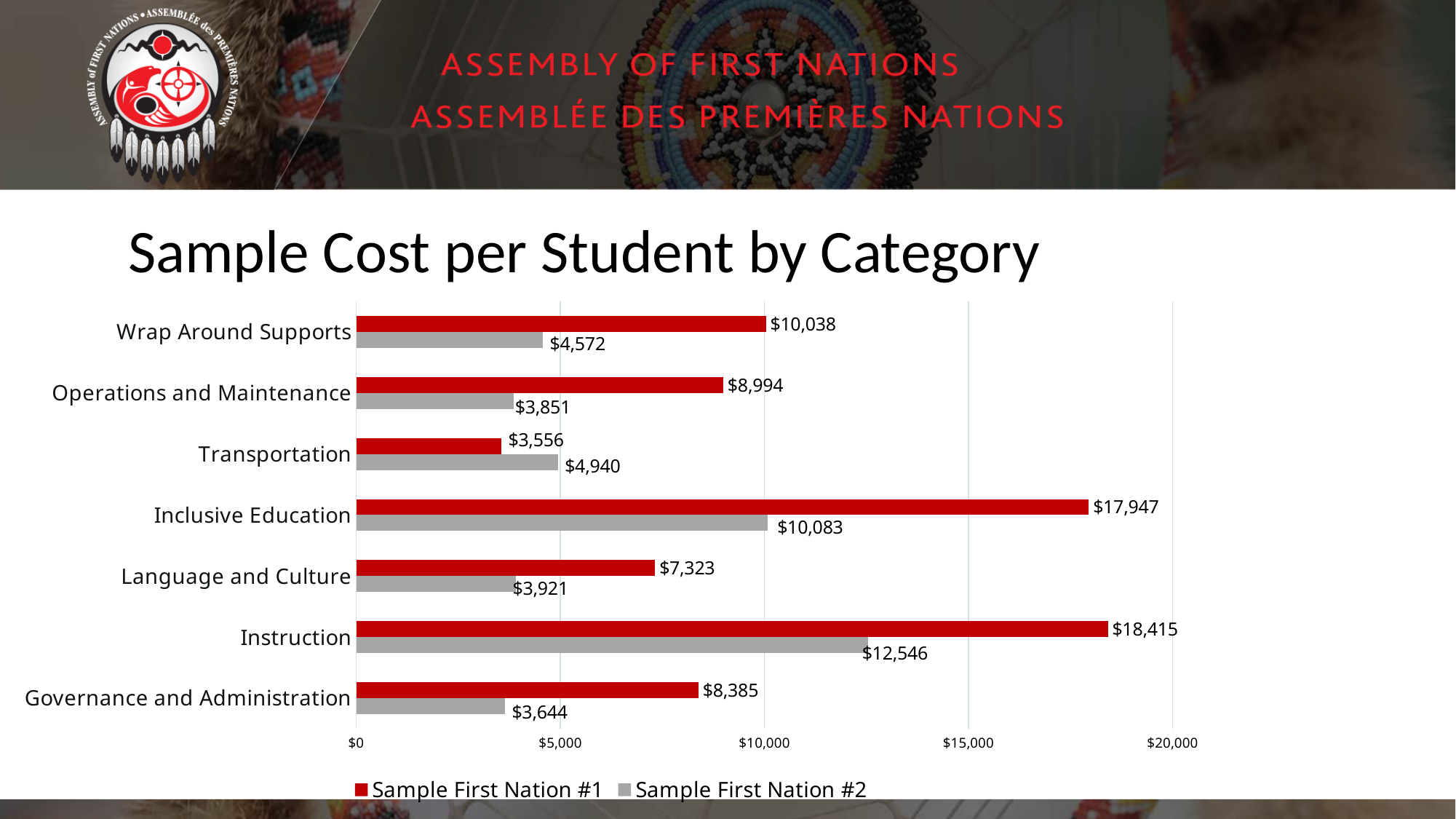
What kind of chart is shown on the slide? Bar chart What is the difference between Sample First Nation #1 and Sample First Nation #2 in the Inclusive Education category? $7,864 In the Transportation category, which series has the larger value, Sample First Nation #1 or Sample First Nation #2? Sample First Nation #2 What is the value for Sample First Nation #2 in the Transportation category? $4,940 How many categories are shown on the chart? 7 How many series does the legend list? 2 What is the title of the chart? Sample Cost per Student by Category Which category has the lowest value for Sample First Nation #2? Governance and Administration Which category has the highest value for Sample First Nation #1? Instruction Is the value for Sample First Nation #2 in the Instruction category greater or less than $10,000? greater What is the value for Sample First Nation #1 in the Instruction category? $18,415 What is the value for Sample First Nation #2 in the Wrap Around Supports category? $4,572